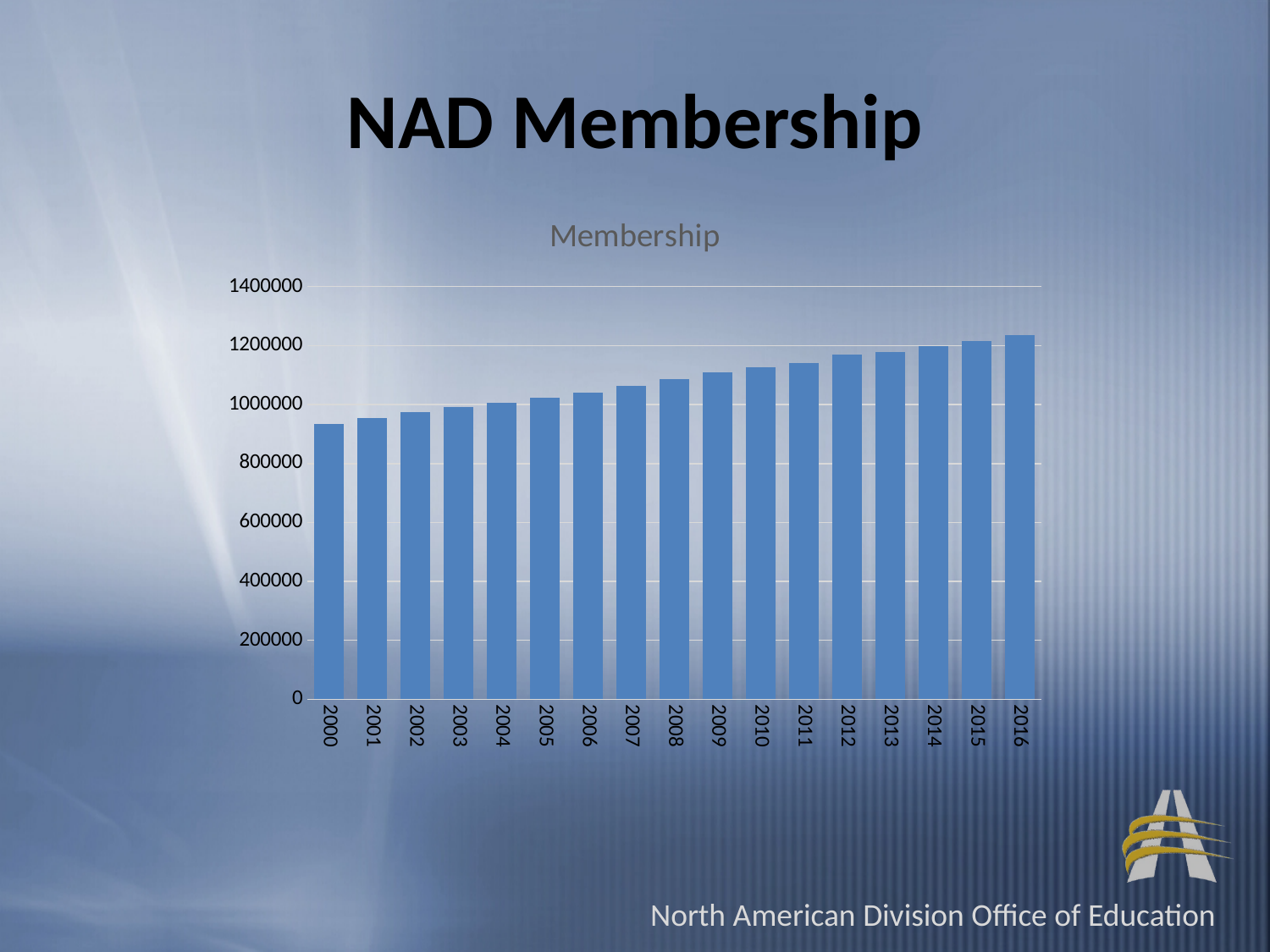
Do the membership values rise or fall from 2000 to 2016? rise What is the title shown above the chart's plot area? Membership Is the membership value for 2012 greater or less than 1200000? less What kind of chart is shown on the slide? bar chart How many years are plotted on the x axis of the chart? 17 Is the membership value for 2016 greater or less than 1200000? greater Which year has the larger membership, 2003 or 2008? 2008 Which year has the lowest membership in the chart? 2000 Is the membership value for 2000 greater or less than 1000000? less Which year has the highest membership in the chart? 2016 What is the highest value labelled on the chart's vertical axis? 1400000